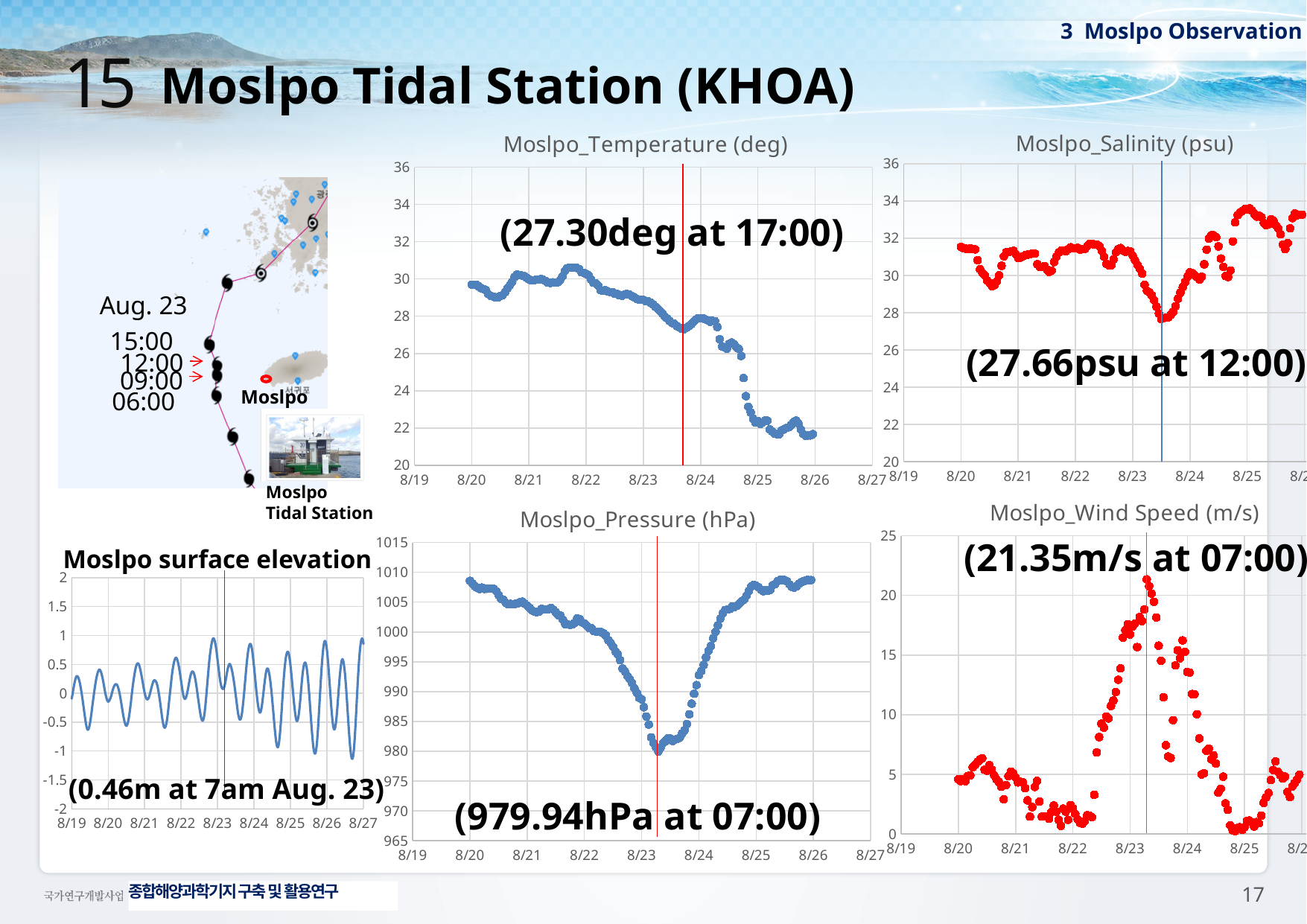
On the Moslpo_Salinity (psu) chart, is the value at 8/25 greater or less than 32? greater What colour are the data points on the Moslpo_Salinity (psu) and Moslpo_Wind Speed (m/s) charts? red On the Moslpo_Wind Speed (m/s) chart, what wind speed is annotated at 07:00? 21.35m/s On the Moslpo_Temperature (deg) chart, what temperature value is annotated at 17:00? 27.30deg On the Moslpo_Temperature (deg) chart, is the value at 8/26 greater or less than 24? less On the Moslpo surface elevation chart, what elevation value is annotated at 7am Aug. 23? 0.46m On the Moslpo_Temperature (deg) chart, do the values generally rise or fall from 8/20 to 8/26? fall On the Moslpo_Salinity (psu) chart, what salinity value is annotated at 12:00? 27.66psu On the Moslpo_Pressure (hPa) chart, what is the annotated minimum pressure at 07:00? 979.94hPa What kind of chart is the Moslpo surface elevation chart? line chart On the Moslpo_Wind Speed (m/s) chart, is the value at 8/21 greater or less than 5? less